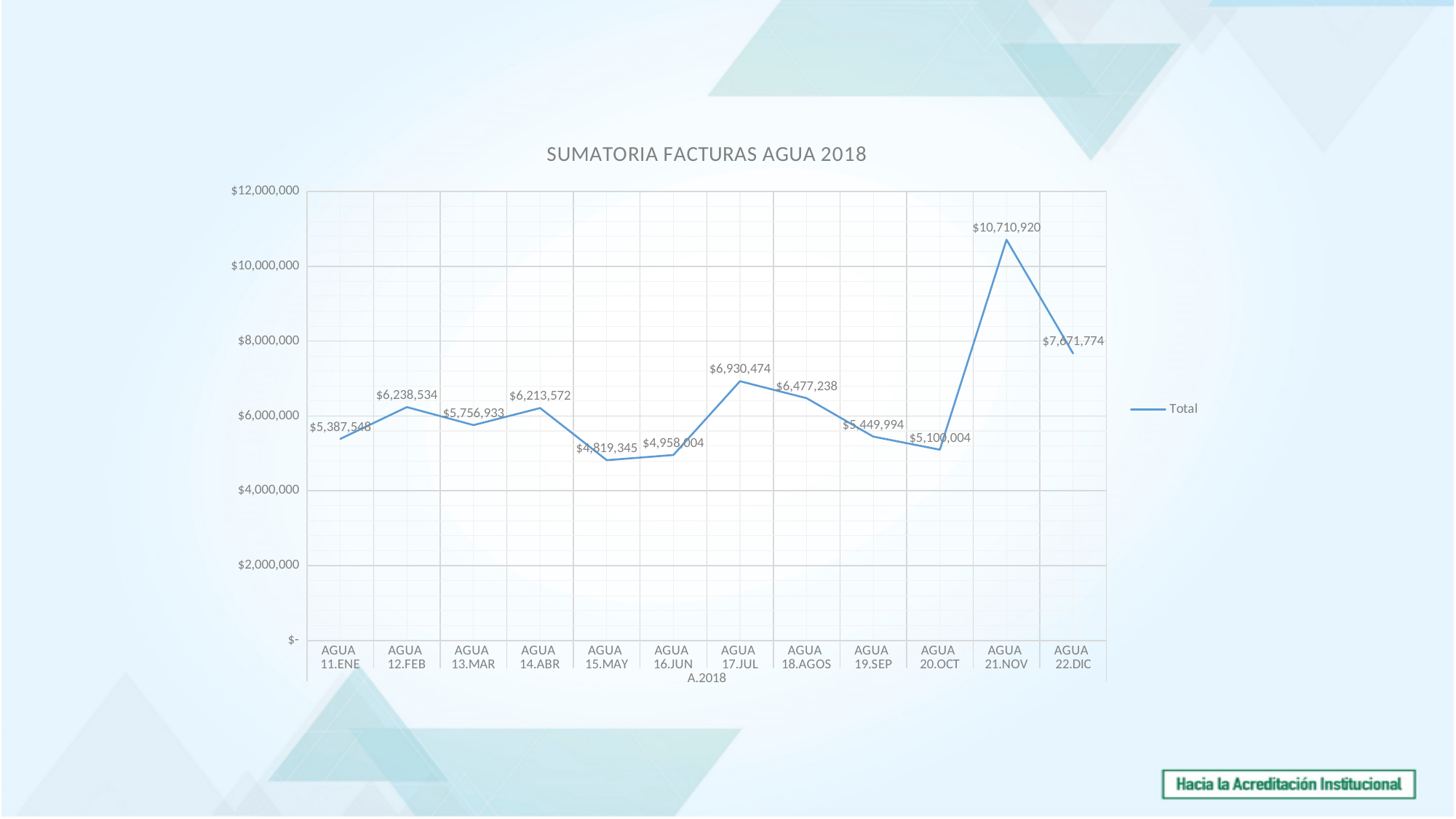
What is the value for AGUA 21.NOV? $10,710,920 How many categories are plotted on the x axis? 12 Which is larger, the value for AGUA 12.FEB or the value for AGUA 13.MAR? AGUA 12.FEB What is the difference between the values for AGUA 21.NOV and AGUA 22.DIC? $3,039,146 What is the title of the chart? SUMATORIA FACTURAS AGUA 2018 Which category has the lowest value? AGUA 15.MAY What type of chart is shown on the slide? Line chart How many series does the legend list? 1 What is the value for AGUA 17.JUL? $6,930,474 Is the value for AGUA 22.DIC greater or less than $8,000,000? less What is the value for AGUA 15.MAY? $4,819,345 Which category has the highest value? AGUA 21.NOV